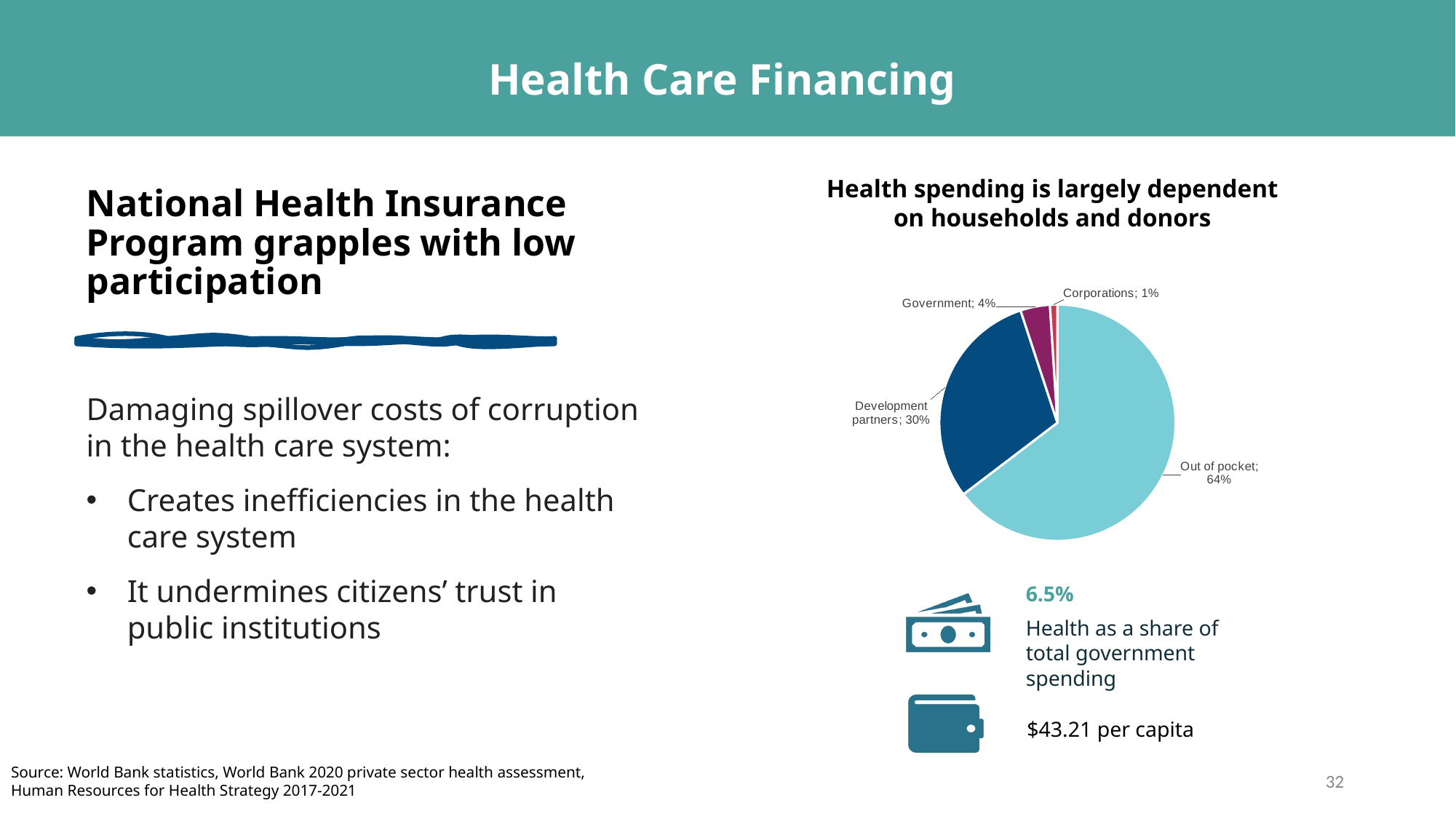
Which source accounts for the largest share of health spending? Out of pocket What is the combined share of out of pocket and development partners? 94% Which is larger, the government share or the corporations share? Government Which source accounts for the smallest share of health spending? Corporations What share of health spending comes from out of pocket? 64% What is the title of the pie chart? Health spending is largely dependent on households and donors What is the difference in percentage points between the out of pocket share and the development partners share? 34 What share of health spending comes from development partners? 30% How many slices does the pie chart have? 4 What share of health spending comes from government? 4% What share of health spending comes from corporations? 1% What type of chart is shown on the slide? pie chart